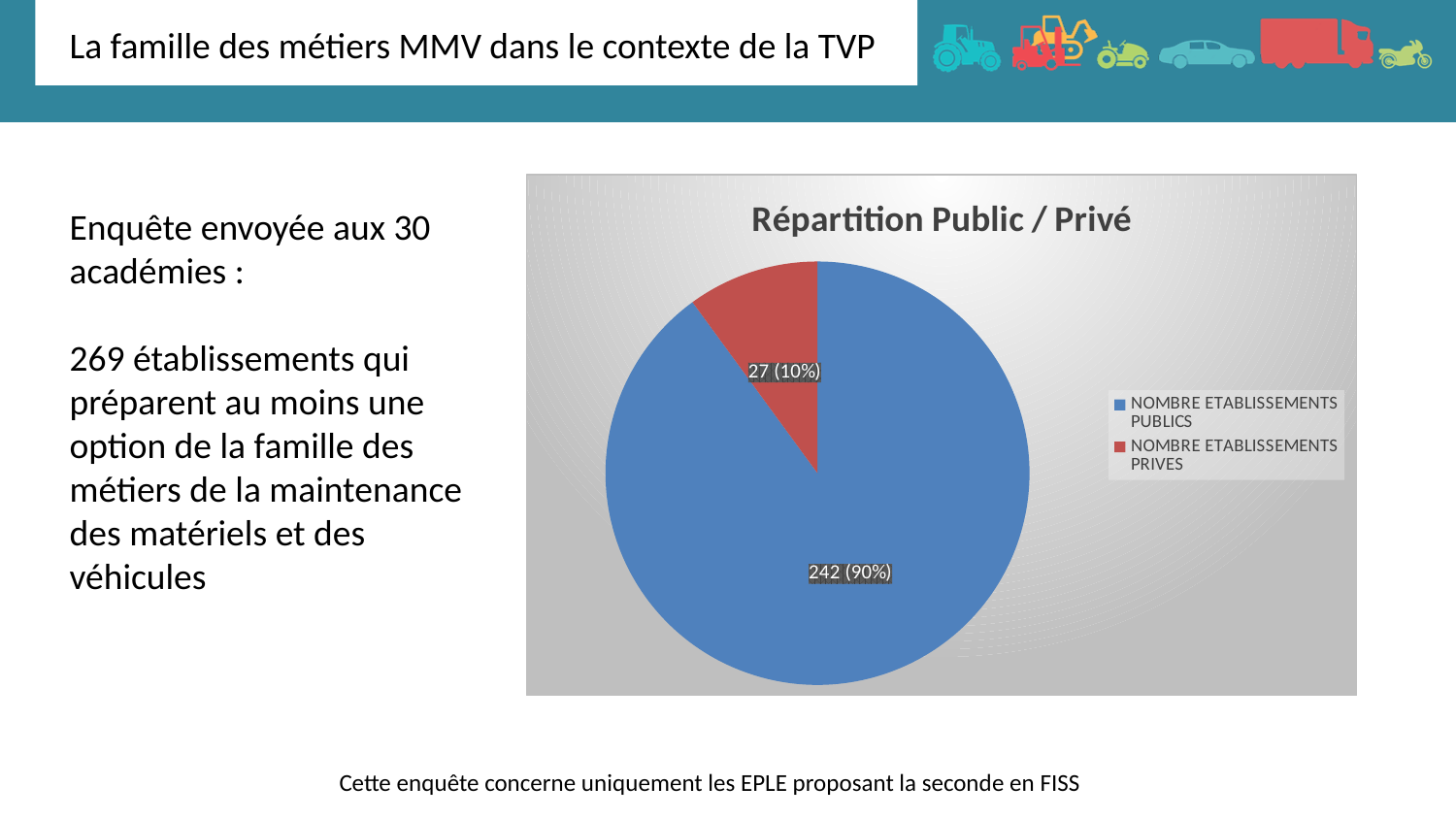
What type of chart is shown on the slide? pie chart How many slices does the pie chart have? 2 Which category has the largest slice? NOMBRE ETABLISSEMENTS PUBLICS What is the value for NOMBRE ETABLISSEMENTS PUBLICS? 242 What is the title of the chart? Répartition Public / Privé Which category has the smallest slice? NOMBRE ETABLISSEMENTS PRIVES What share of the pie does NOMBRE ETABLISSEMENTS PUBLICS represent? 90% How many entries does the legend list? 2 What is the value for NOMBRE ETABLISSEMENTS PRIVES? 27 What colour is the slice for NOMBRE ETABLISSEMENTS PRIVES? red What is the difference between the number of public and private establishments? 215 What share of the pie does NOMBRE ETABLISSEMENTS PRIVES represent? 10%